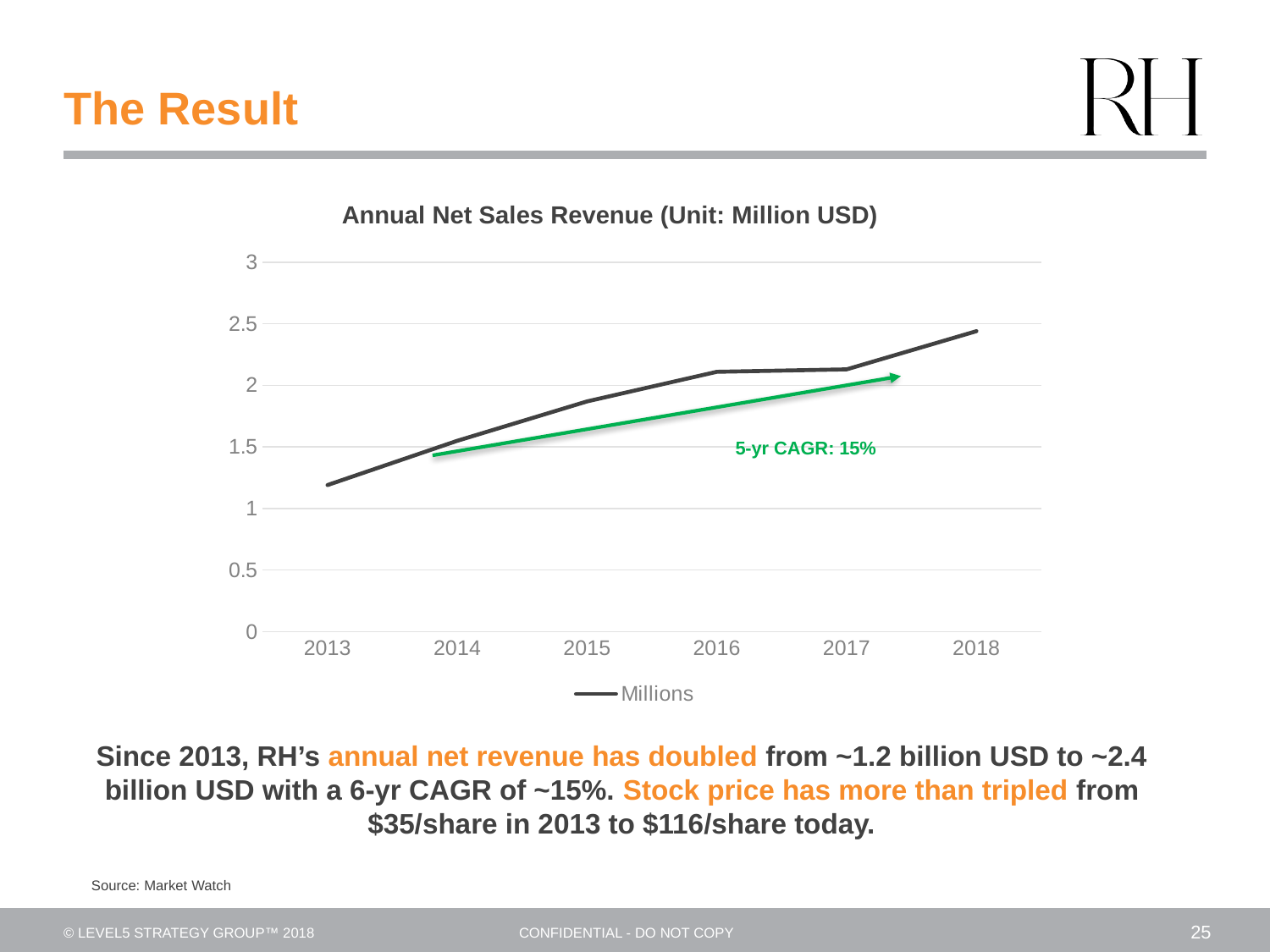
Which year has the highest annual net sales revenue in the chart? 2018 Do the values in the chart rise or fall from 2013 to 2018? rise How many series does the chart legend list? 1 Is the value for 2018 greater or less than 2? greater How many years are plotted on the x axis of the chart? 6 Which year has the lowest annual net sales revenue in the chart? 2013 Is the value for 2015 greater or less than 1.5? greater What is the title of the chart? Annual Net Sales Revenue (Unit: Million USD) Is the value for 2013 greater or less than 1.5? less What 5-year CAGR is annotated on the chart? 15% What kind of chart is shown on the slide? line chart